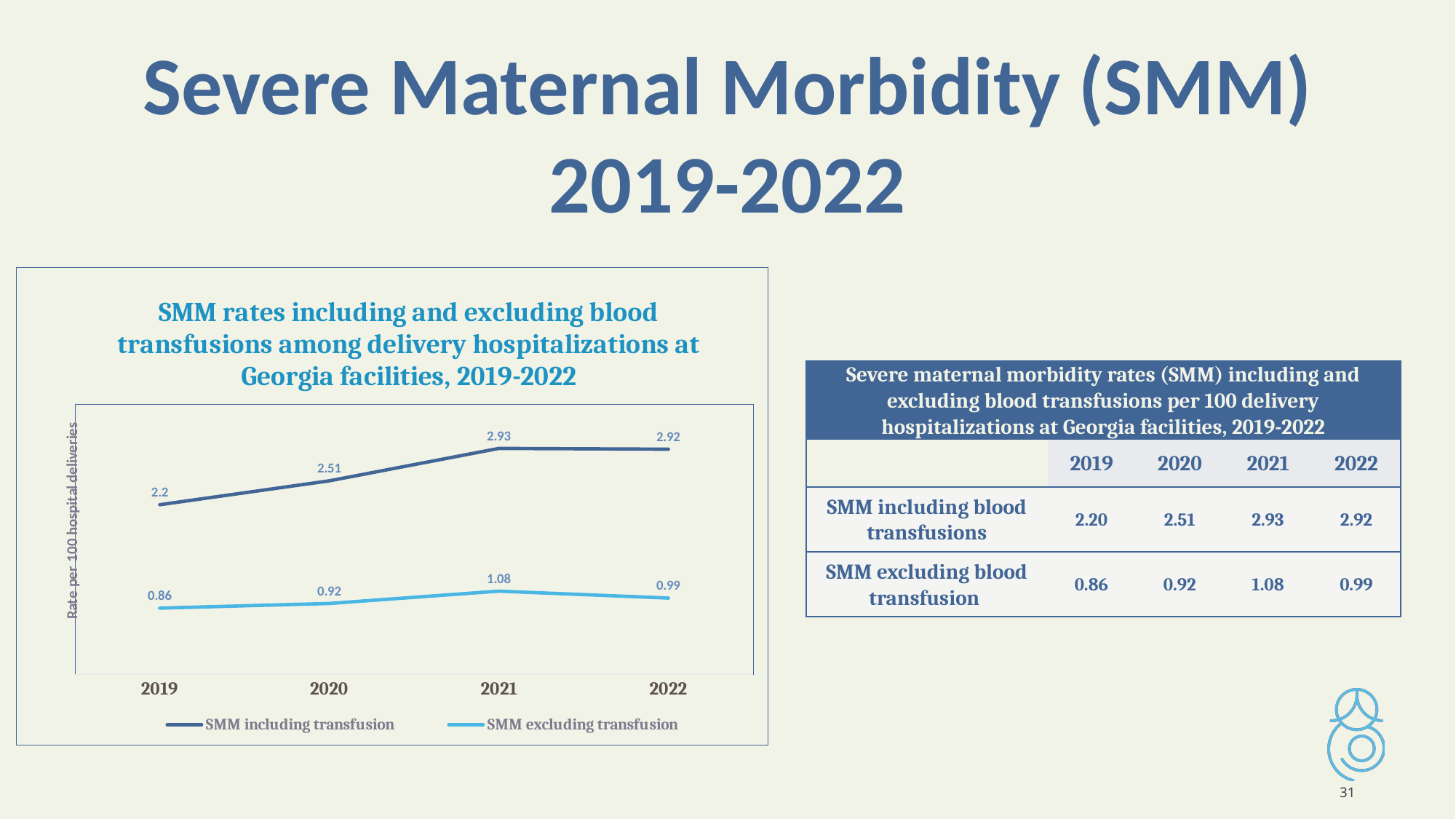
Does the SMM including transfusion series rise or fall from 2019 to 2021? Rise What is the value for SMM excluding transfusion in 2022? 0.99 Which is larger: the SMM excluding transfusion value in 2021 or in 2022? 2021 What is the difference between the SMM including transfusion and SMM excluding transfusion values in 2020? 1.59 What kind of chart is shown on the slide? Line chart How many series does the chart legend list? 2 What is the value for SMM excluding transfusion in 2019? 0.86 In which year is the SMM including transfusion value highest? 2021 How many years are plotted on the x axis of the chart? 4 In which year is the SMM excluding transfusion value lowest? 2019 What is the value for SMM including transfusion in 2021? 2.93 What is the label of the chart's y axis? Rate per 100 hospital deliveries